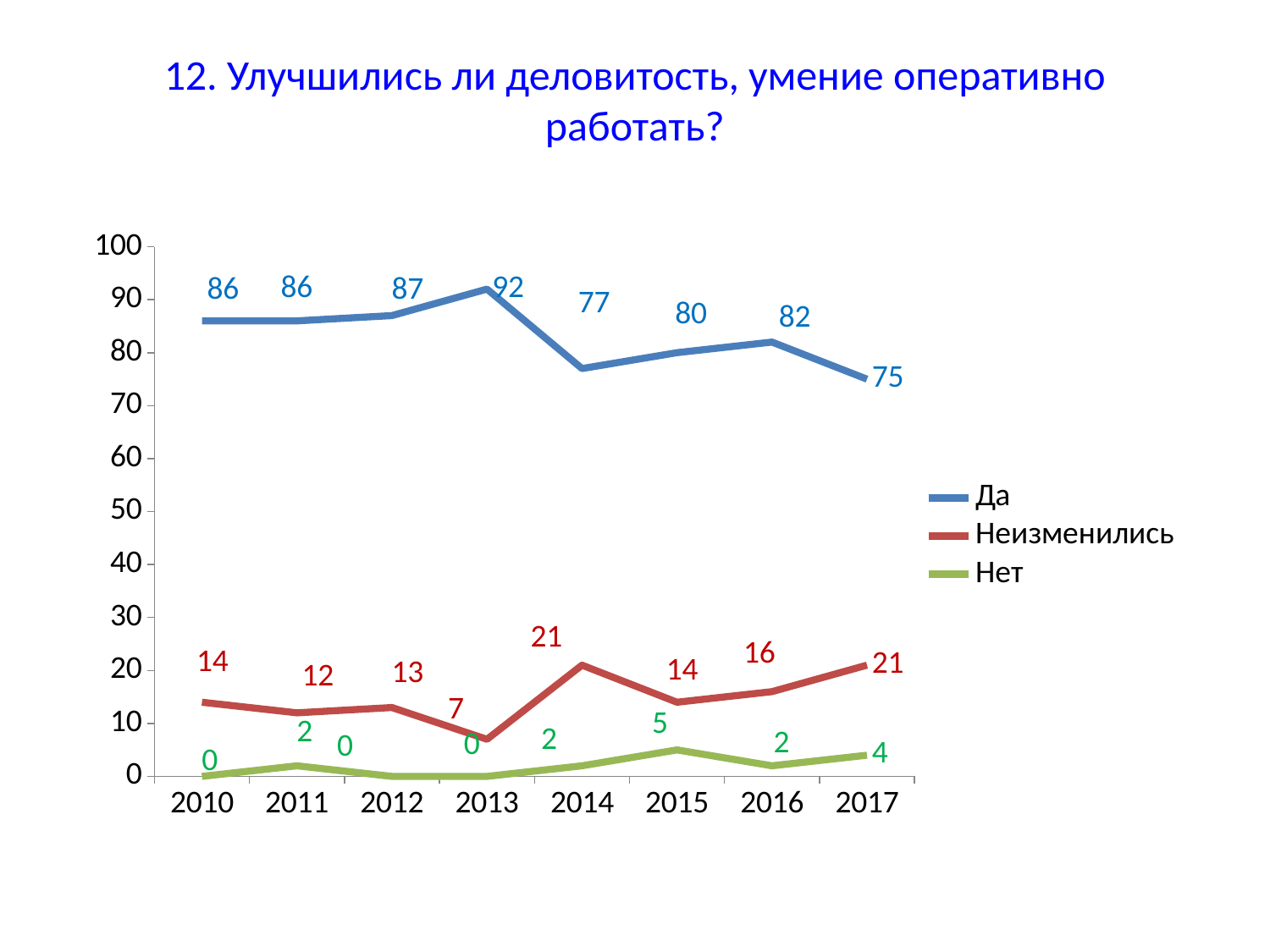
Which is larger: the "Неизменились" value in 2011 or in 2016? 2016 What kind of chart is shown on the slide? line chart In which year is the "Да" series at its lowest? 2017 How many series does the legend list? 3 What is the value for "Неизменились" in 2014? 21 Does the "Да" series rise or fall from 2013 to 2017? fall What colour is the line for "Нет"? green In which year is the "Да" series at its highest? 2013 What is the difference between the "Да" values in 2013 and 2014? 15 What is the value for "Да" in 2013? 92 How many years are shown on the x axis? 8 What is the value for "Нет" in 2015? 5